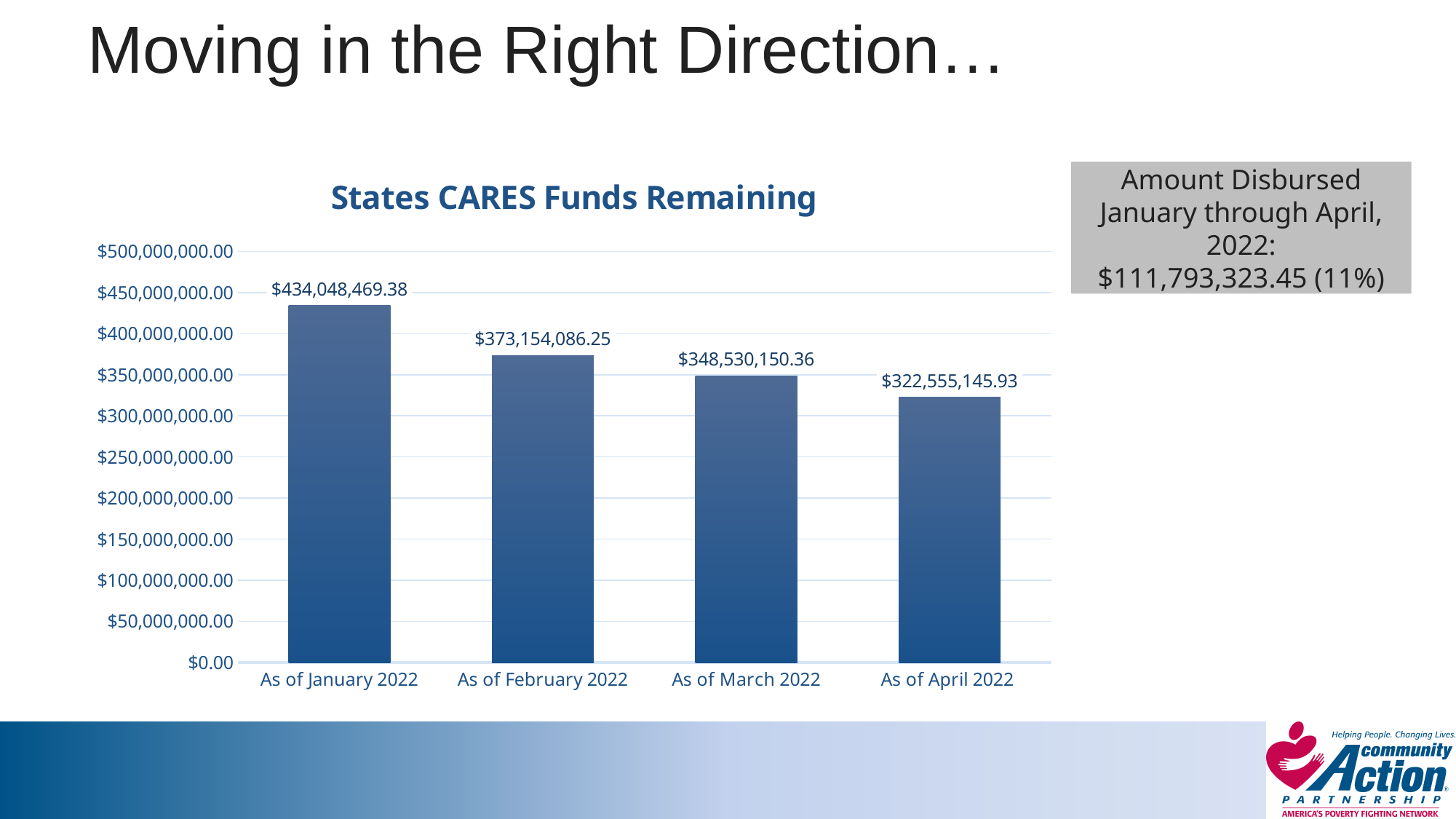
Is the value for As of April 2022 greater or less than $350,000,000.00? less What kind of chart is the States CARES Funds Remaining chart? bar chart How many categories are shown in the States CARES Funds Remaining chart? 4 What is the value for As of April 2022 in the States CARES Funds Remaining chart? $322,555,145.93 What is the difference between the values for As of March 2022 and As of April 2022? $25,975,004.43 Which category has the lowest value in the States CARES Funds Remaining chart? As of April 2022 Do the values rise or fall from January 2022 to April 2022 in the States CARES Funds Remaining chart? fall What is the value for As of January 2022 in the States CARES Funds Remaining chart? $434,048,469.38 Which is larger, the value for As of February 2022 or As of March 2022? As of February 2022 What is the difference between the values for As of January 2022 and As of February 2022? $60,894,383.13 What is the value for As of March 2022 in the States CARES Funds Remaining chart? $348,530,150.36 Which category has the highest value in the States CARES Funds Remaining chart? As of January 2022